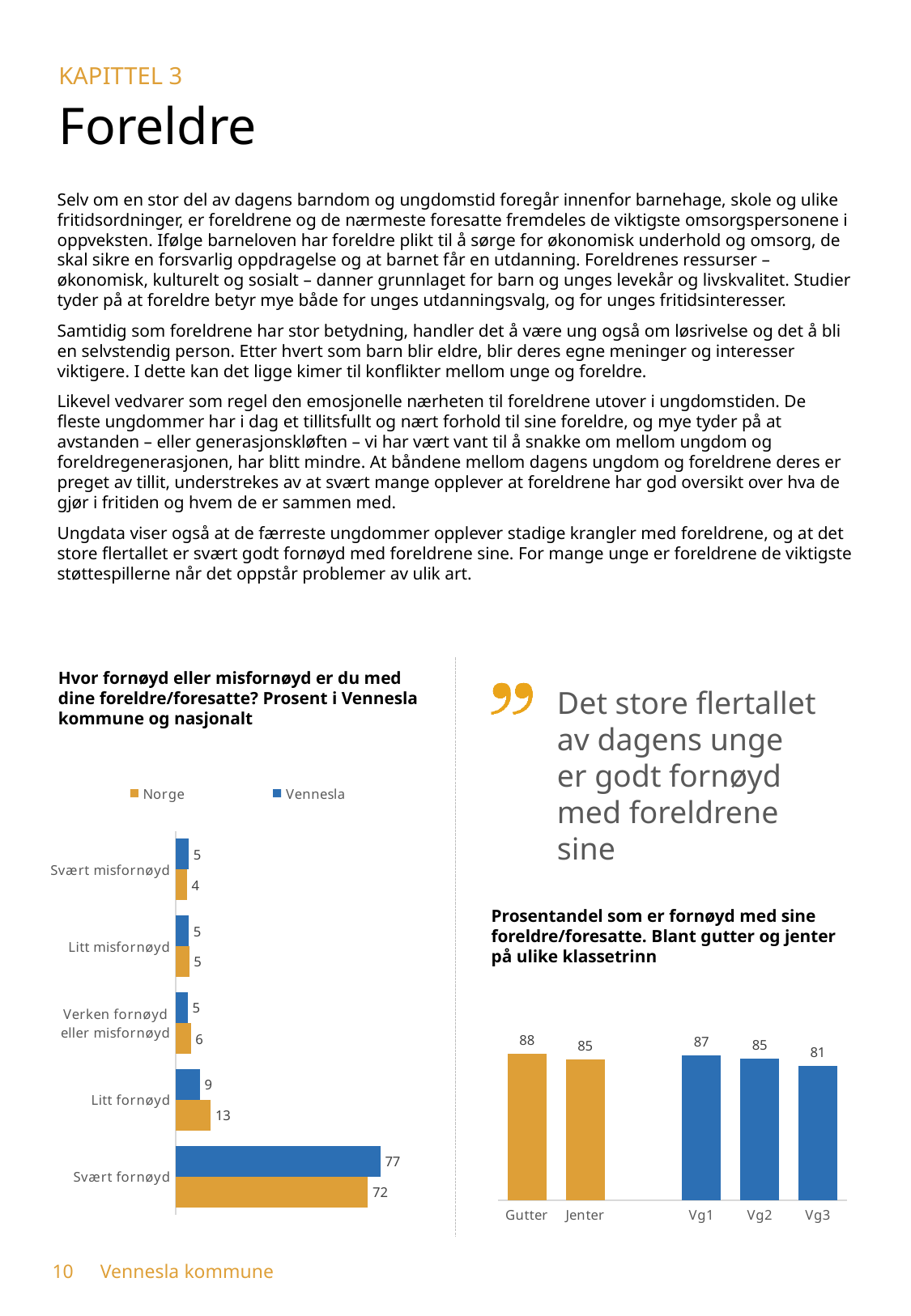
In the chart 'Prosentandel som er fornøyd med sine foreldre/foresatte', do the values rise or fall from Vg1 to Vg3? Fall What kind of chart is 'Hvor fornøyd eller misfornøyd er du med dine foreldre/foresatte?'? Bar chart In the chart 'Prosentandel som er fornøyd med sine foreldre/foresatte', which category has the lowest value? Vg3 In the chart 'Hvor fornøyd eller misfornøyd er du med dine foreldre/foresatte?', which category has the highest value for Norge? Svært fornøyd In the chart 'Hvor fornøyd eller misfornøyd er du med dine foreldre/foresatte?', what is the value for Vennesla in the 'Svært fornøyd' category? 77 In the chart 'Hvor fornøyd eller misfornøyd er du med dine foreldre/foresatte?', what is the difference between the Vennesla and Norge values for 'Svært fornøyd'? 5 In the chart 'Prosentandel som er fornøyd med sine foreldre/foresatte', what is the difference between Vg1 and Vg3? 6 In the chart 'Hvor fornøyd eller misfornøyd er du med dine foreldre/foresatte?', what is the value for Norge in the 'Litt fornøyd' category? 13 In the chart 'Hvor fornøyd eller misfornøyd er du med dine foreldre/foresatte?', how many categories are shown? 5 In the chart 'Hvor fornøyd eller misfornøyd er du med dine foreldre/foresatte?', how many series does the legend list? 2 In the chart 'Prosentandel som er fornøyd med sine foreldre/foresatte', what is the value for Gutter? 88 In the chart 'Hvor fornøyd eller misfornøyd er du med dine foreldre/foresatte?', which is larger for 'Litt fornøyd': Norge or Vennesla? Norge